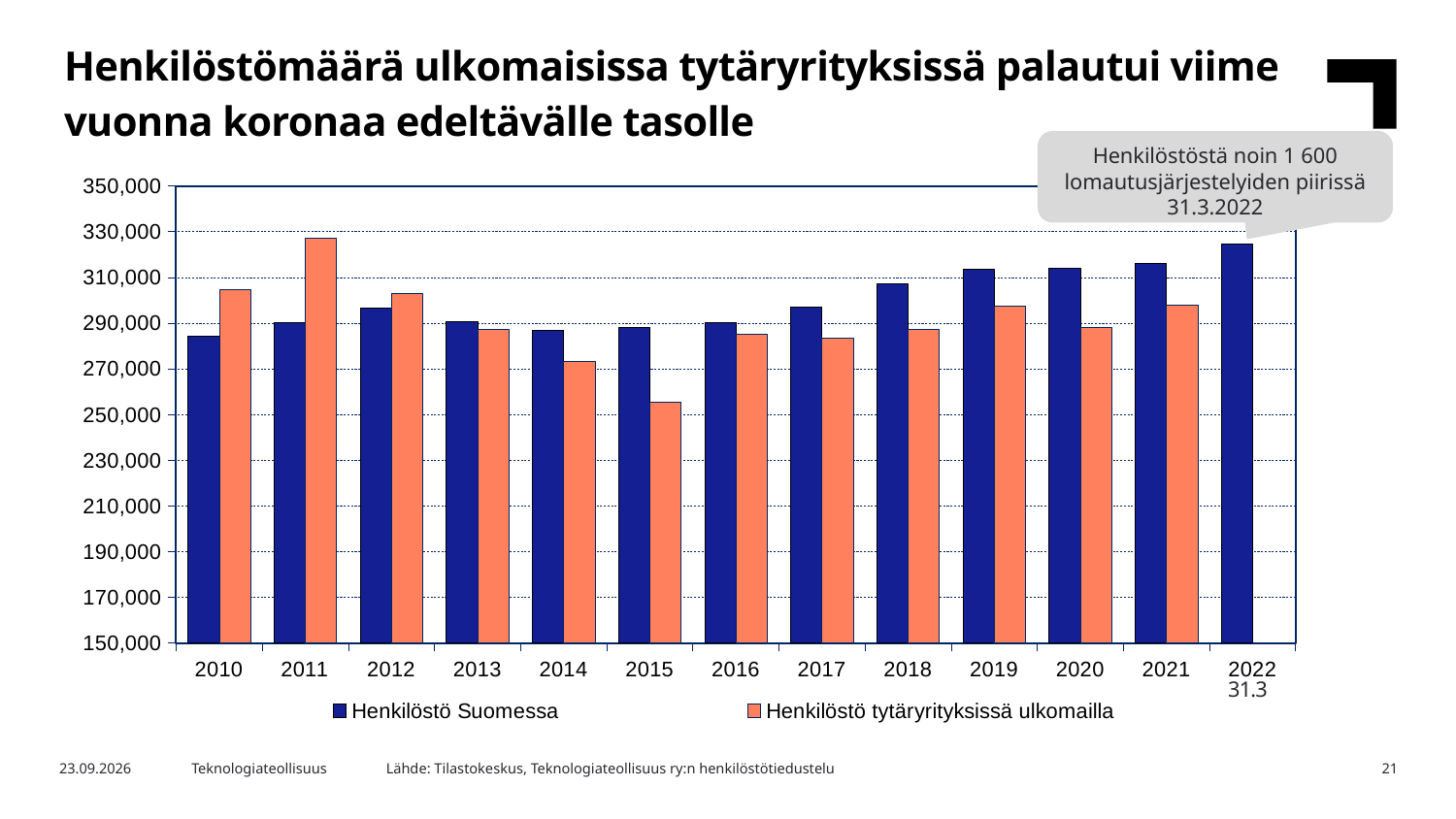
In which year is the value for Henkilöstö tytäryrityksissä ulkomailla lowest? 2015 How many years are shown on the x axis? 13 In which year is the value for Henkilöstö tytäryrityksissä ulkomailla highest? 2011 In 2011, which series has the larger value: Henkilöstö Suomessa or Henkilöstö tytäryrityksissä ulkomailla? Henkilöstö tytäryrityksissä ulkomailla What kind of chart is shown on the slide? bar chart How many series does the legend list? 2 In which year is the value for Henkilöstö Suomessa highest? 2022 Is the value for Henkilöstö Suomessa in 2022 greater or less than 310,000? greater In 2015, which series has the larger value: Henkilöstö Suomessa or Henkilöstö tytäryrityksissä ulkomailla? Henkilöstö Suomessa Is the value for Henkilöstö tytäryrityksissä ulkomailla in 2015 greater or less than 270,000? less Does the value for Henkilöstö Suomessa rise or fall from 2017 to 2022? rise Is the value for Henkilöstö tytäryrityksissä ulkomailla in 2011 greater or less than 310,000? greater